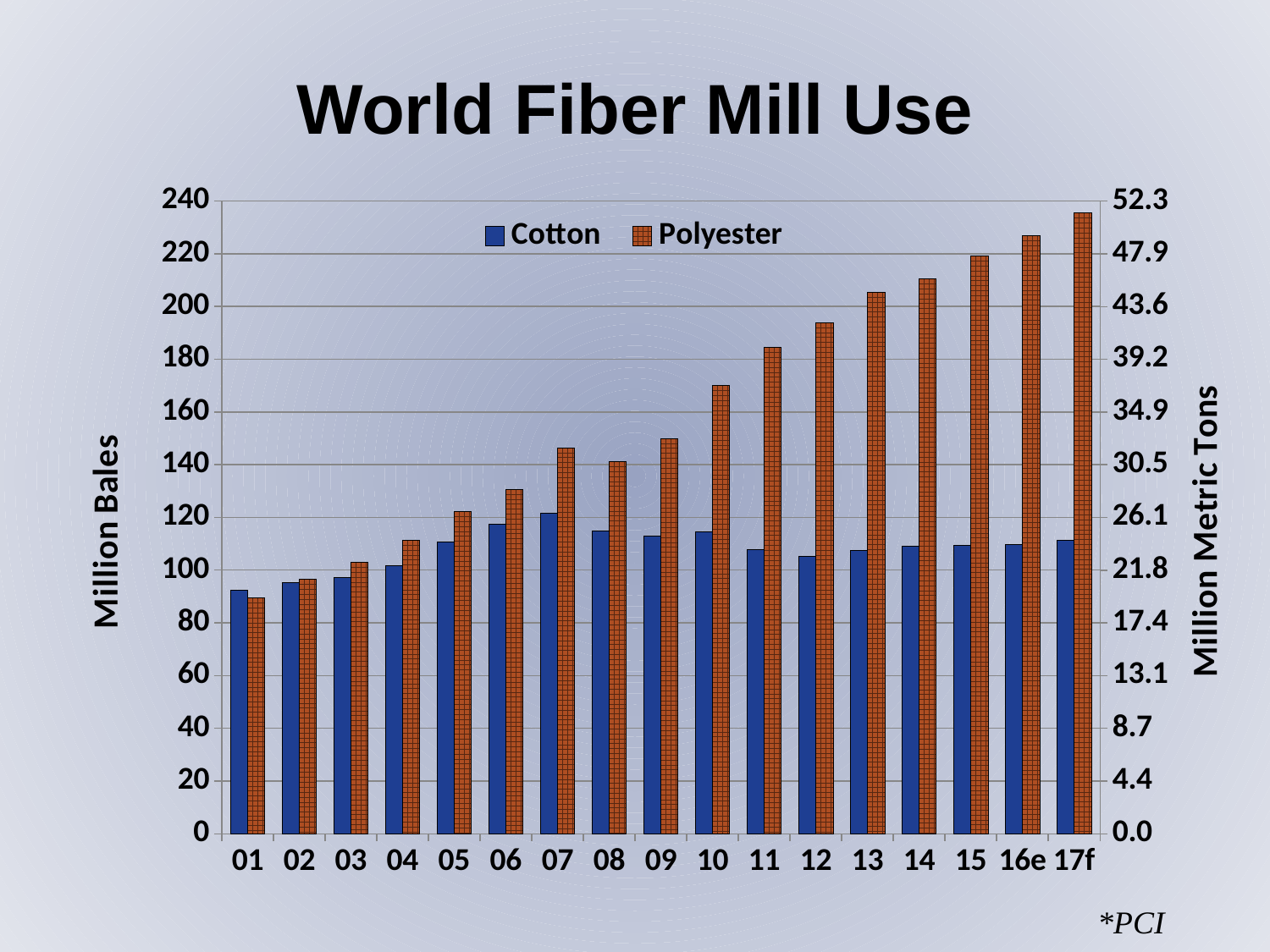
Do the Polyester values generally rise or fall from 01 to 17f? rise How many years (categories) are shown on the x axis? 17 What is the label on the right-hand vertical axis? Million Metric Tons How many series does the legend list? 2 Which year has the highest Polyester value? 17f What kind of chart is shown on the slide? bar chart Which year has the lowest Cotton value? 01 Which year has the lowest Polyester value? 01 What is the title of the chart? World Fiber Mill Use Is the Cotton value for 01 greater or less than 100 million bales? less Is the Polyester value for 10 greater or less than 34.9 million metric tons? greater Is the Polyester value for 17f greater or less than 47.9 million metric tons? greater